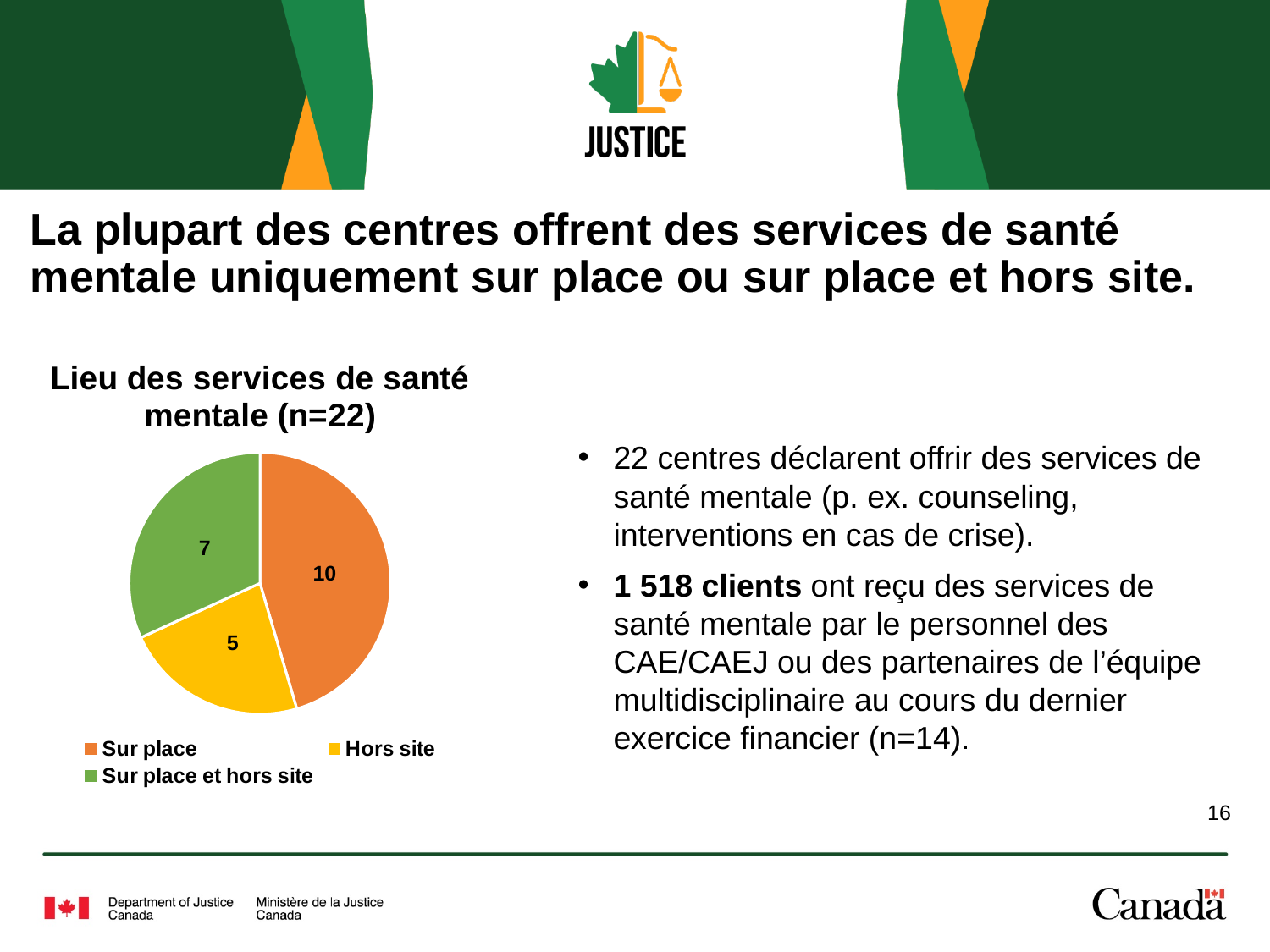
What is the value for "Hors site"? 5 Which category has the smallest slice? Hors site What is the value for "Sur place"? 10 Which category has the largest slice? Sur place What is the value for "Sur place et hors site"? 7 What is the difference between the values for "Sur place" and "Hors site"? 5 What is the total of all slices in the pie chart? 22 What is the title of the chart? Lieu des services de santé mentale (n=22) Which is larger, "Sur place et hors site" or "Hors site"? Sur place et hors site What type of chart is shown on the slide? pie chart How many slices does the pie chart have? 3 What colour is the "Hors site" slice? yellow